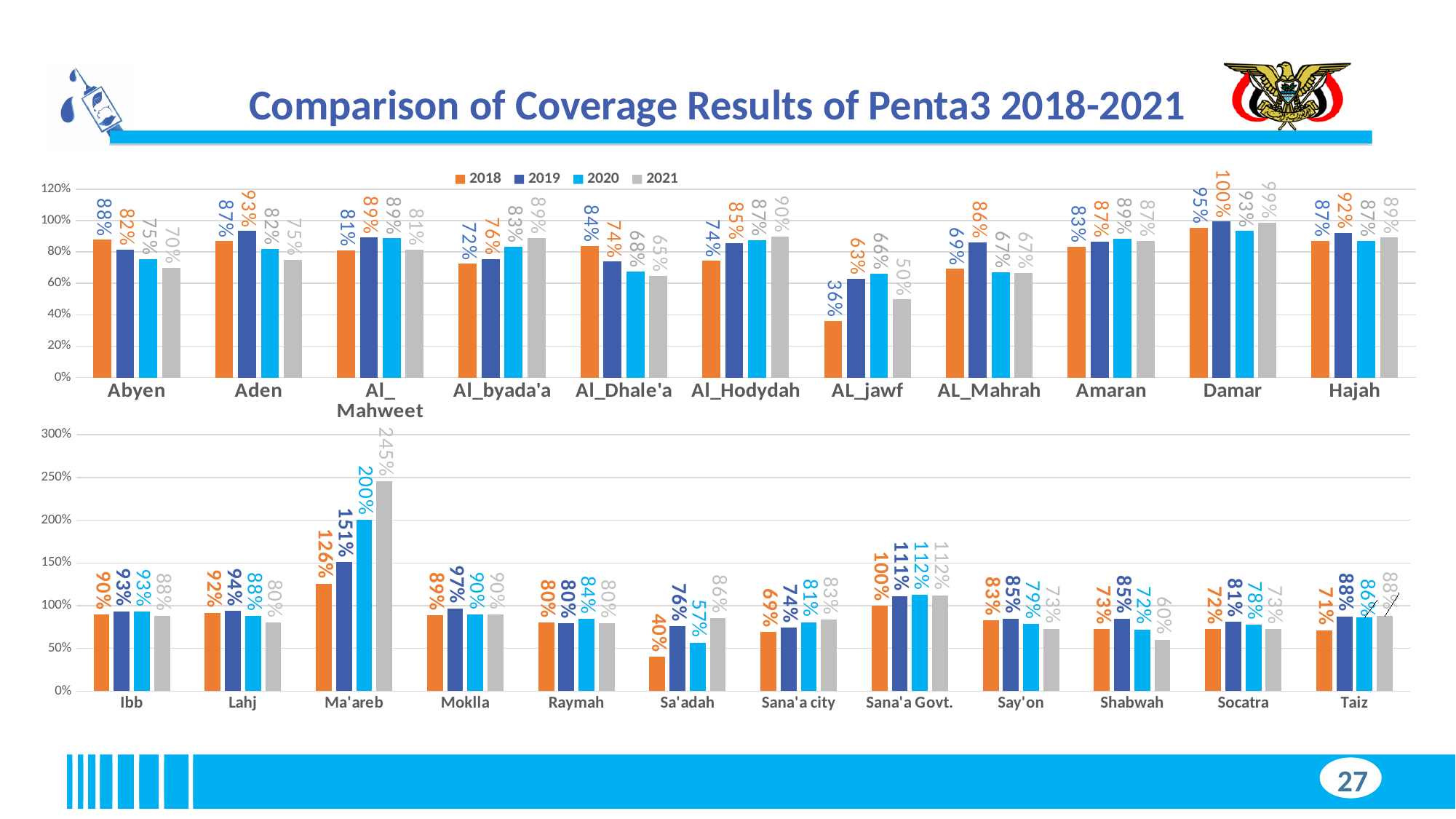
In the bottom chart, which is larger: the 2020 coverage for Shabwah or for Socatra? Socatra In the top chart, which governorate had the highest 2019 coverage? Damar How many governorates are shown in the bottom chart? 12 In the top chart, what was the Penta3 coverage for Abyen in 2018? 88% In the bottom chart, what is the difference between the 2020 and 2019 coverage for Ma'areb? 49% In the top chart, which governorate had the lowest 2018 coverage? AL_jawf In the bottom chart, what was the 2021 coverage for Ma'areb? 245% In the bottom chart, which governorate had the lowest 2018 coverage? Sa'adah In the top chart, does the coverage for Abyen rise or fall from 2018 to 2021? Fall In the top chart, what was the 2021 coverage for Al_Hodydah? 90% How many series does the legend list? 4 In the top chart, what is the difference between the 2019 and 2018 coverage for AL_jawf? 27%